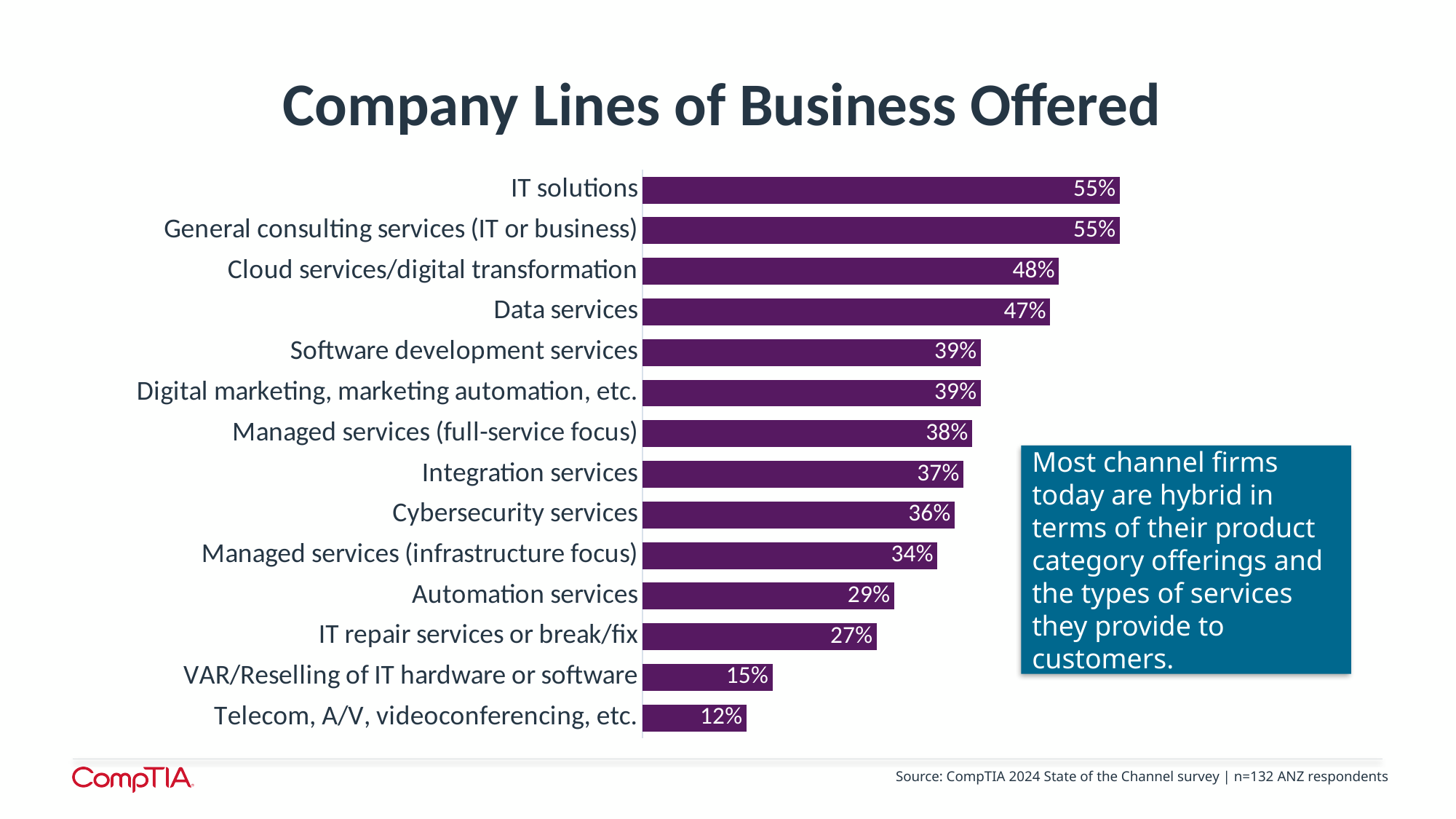
What is the difference between the values for Data services and Automation services? 18% How many lines of business are shown on the chart? 14 What is the value for Cybersecurity services? 36% What percentage of respondents offer Cloud services/digital transformation? 48% Which is larger: IT repair services or break/fix or Integration services? Integration services What kind of chart is shown on the slide? Bar chart What is the difference between IT solutions and Telecom, A/V, videoconferencing, etc.? 43% What is the value for VAR/Reselling of IT hardware or software? 15% What is the title of the chart? Company Lines of Business Offered Which is larger: Managed services (full-service focus) or Managed services (infrastructure focus)? Managed services (full-service focus) Which line of business has the lowest value on the chart? Telecom, A/V, videoconferencing, etc. What is the value for Software development services? 39%